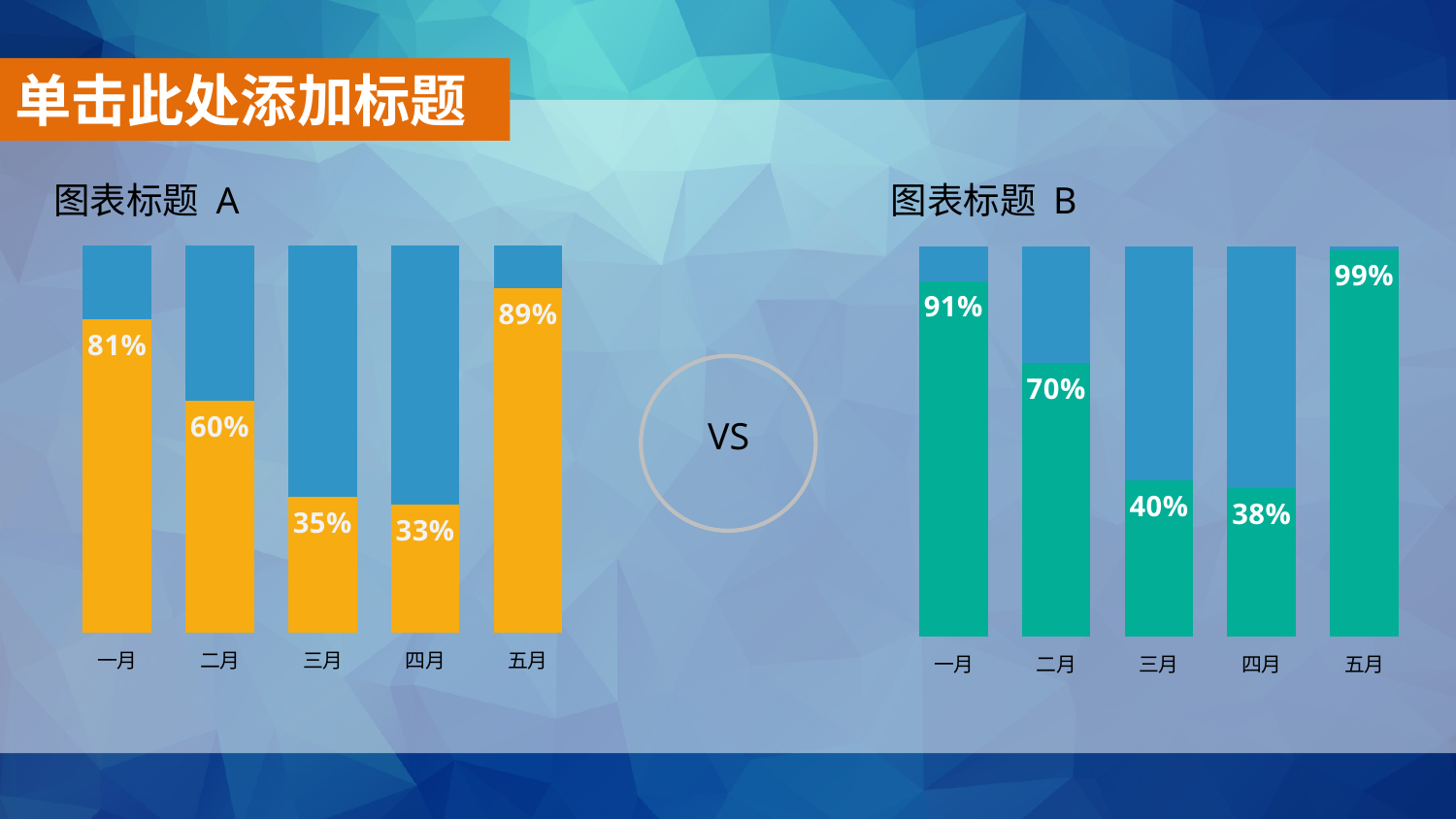
In the chart titled 图表标题 A, how many months are shown on the x axis? 5 In the chart titled 图表标题 B, which month has the lowest labelled value? 四月 In the chart titled 图表标题 B, what is the value for 四月? 38% In the chart titled 图表标题 B, what is the difference between the values for 五月 and 三月? 59% In the chart titled 图表标题 A, what is the value for 五月? 89% What kind of chart is 图表标题 B? bar chart In the chart titled 图表标题 B, do the labelled values rise or fall from 一月 to 四月? fall In the chart titled 图表标题 A, what is the difference between the values for 一月 and 四月? 48% Which is larger: the value for 三月 in 图表标题 A or the value for 三月 in 图表标题 B? 图表标题 B In the chart titled 图表标题 A, which month has the highest labelled value? 五月 What colour are the labelled bar segments in the chart titled 图表标题 A? orange In the chart titled 图表标题 A, what is the value for 二月? 60%